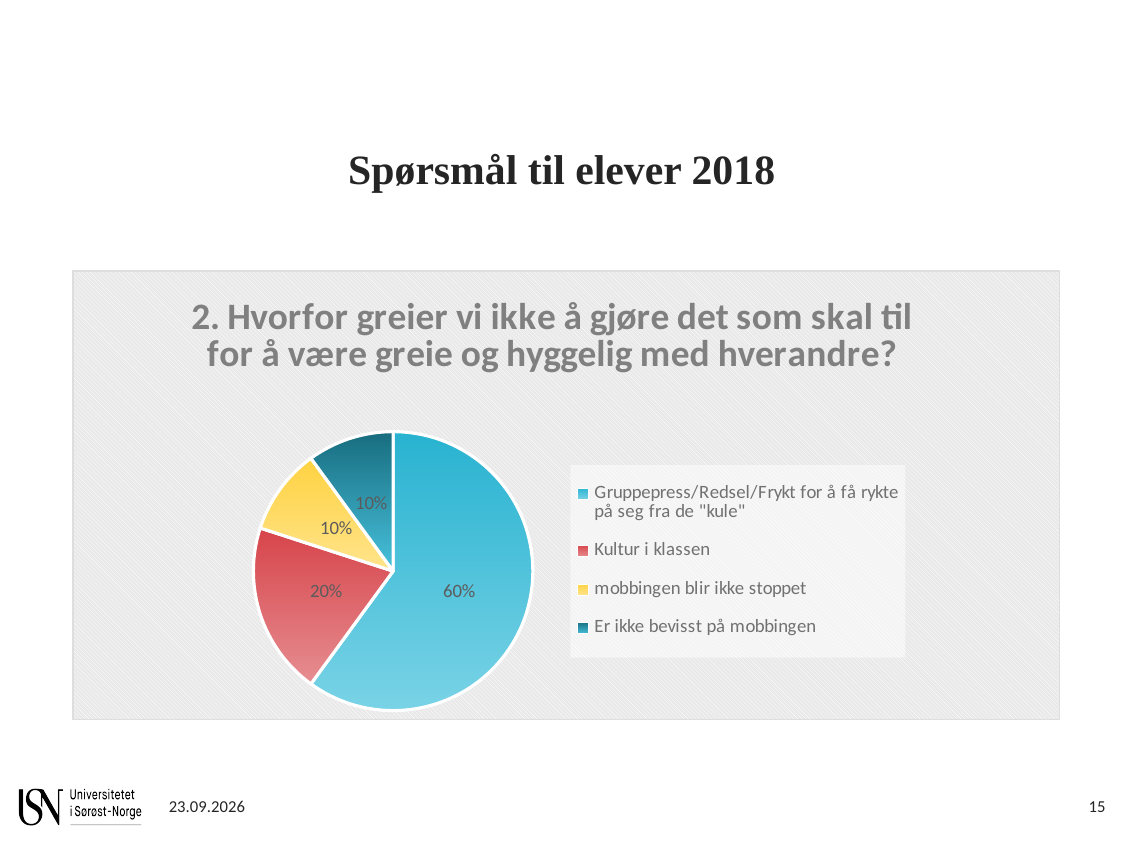
What is the value shown for "Er ikke bevisst på mobbingen"? 10% What is the difference between the share for "Gruppepress/Redsel/Frykt for å få rykte på seg fra de "kule"" and the share for "Kultur i klassen"? 40% What is the title of the chart? 2. Hvorfor greier vi ikke å gjøre det som skal til for å være greie og hyggelig med hverandre? Which is larger: the share for "Kultur i klassen" or the share for "mobbingen blir ikke stoppet"? Kultur i klassen What is the value shown for "mobbingen blir ikke stoppet"? 10% Which category has the largest slice of the pie? Gruppepress/Redsel/Frykt for å få rykte på seg fra de "kule" What share of the pie does "Kultur i klassen" represent? 20% What colour is the slice for "Kultur i klassen"? Red What is the value shown for "Gruppepress/Redsel/Frykt for å få rykte på seg fra de "kule""? 60% What kind of chart is shown on the slide? Pie chart What is the combined share of "mobbingen blir ikke stoppet" and "Er ikke bevisst på mobbingen"? 20% How many categories does the pie chart show? 4